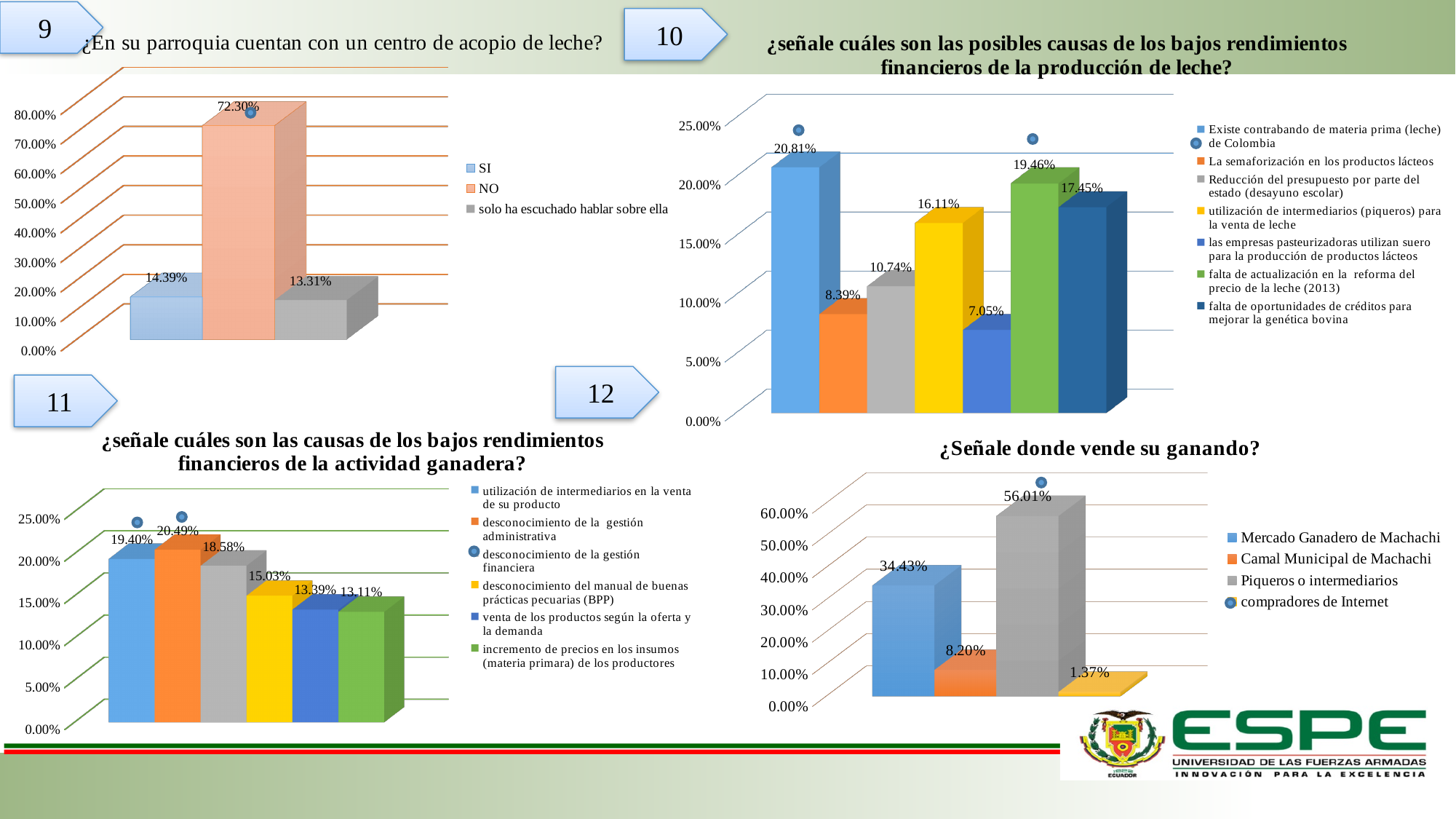
In the chart '¿Señale donde vende su ganando?', what is the value for 'Piqueros o intermediarios'? 56.01% In the chart '¿señale cuáles son las causas de los bajos rendimientos financieros de la actividad ganadera?', what is the value for 'desconocimiento del manual de buenas prácticas pecuarias (BPP)'? 15.03% In the chart '¿Señale donde vende su ganando?', which is larger: 'Mercado Ganadero de Machachi' or 'Camal Municipal de Machachi'? Mercado Ganadero de Machachi What kind of chart is '¿Señale donde vende su ganando?'? bar chart In the chart '¿señale cuáles son las causas de los bajos rendimientos financieros de la actividad ganadera?', which category has the highest value? desconocimiento de la gestión administrativa In the chart '¿señale cuáles son las posibles causas de los bajos rendimientos financieros de la producción de leche?', what is the value for 'utilización de intermediarios (piqueros) para la venta de leche'? 16.11% In the chart '¿En su parroquia cuentan con un centro de acopio de leche?', what is the difference between the values for NO and SI? 57.91% In the chart '¿señale cuáles son las posibles causas de los bajos rendimientos financieros de la producción de leche?', which category has the highest value? Existe contrabando de materia prima (leche) de Colombia In the chart '¿En su parroquia cuentan con un centro de acopio de leche?', which category has the lowest value? solo ha escuchado hablar sobre ella In the chart '¿En su parroquia cuentan con un centro de acopio de leche?', what is the value for NO? 72.30% In the chart '¿señale cuáles son las posibles causas de los bajos rendimientos financieros de la producción de leche?', how many categories does the legend list? 7 In the chart '¿señale cuáles son las posibles causas de los bajos rendimientos financieros de la producción de leche?', what is the value for 'las empresas pasteurizadoras utilizan suero para la producción de productos lácteos'? 7.05%